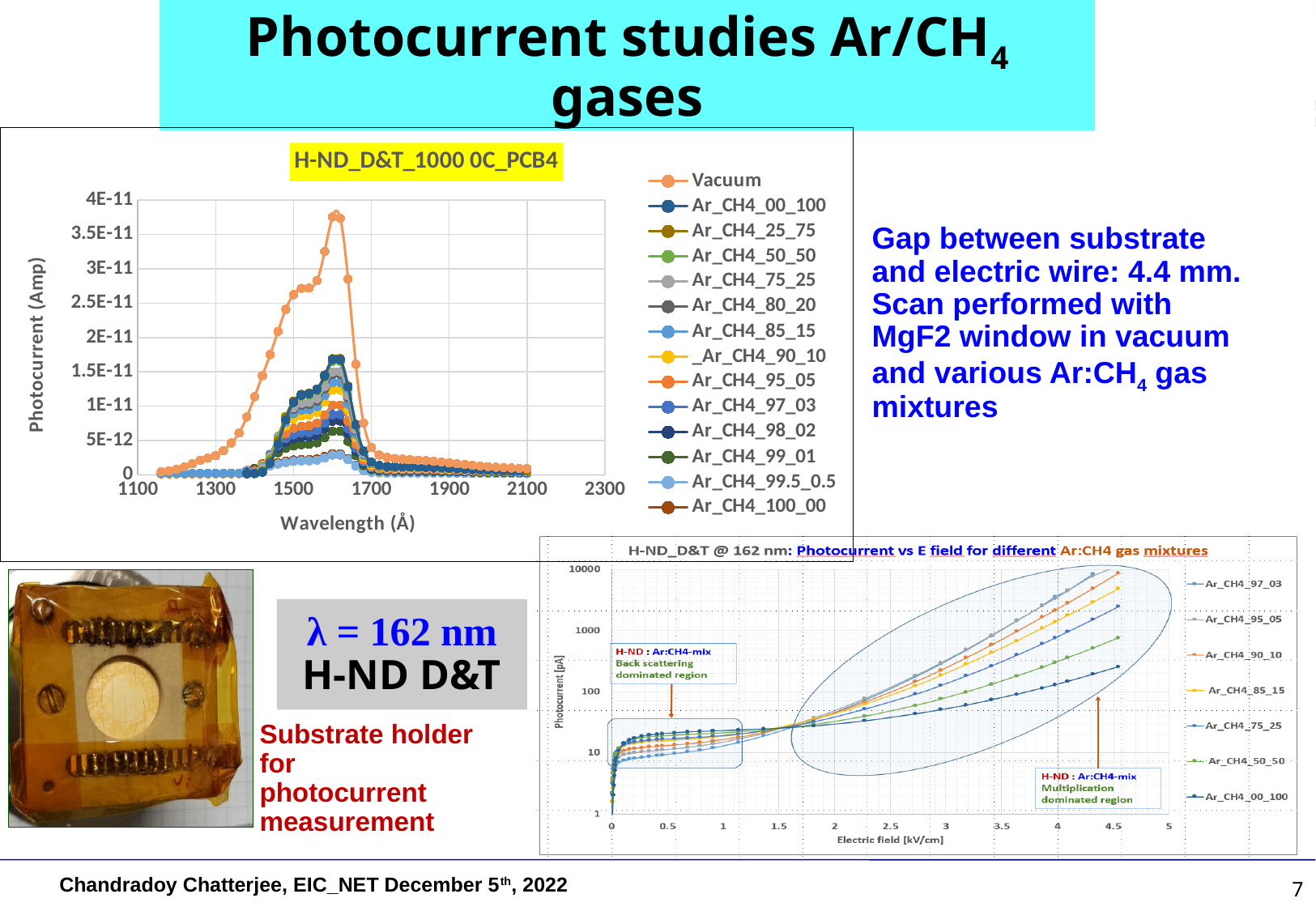
In the top-left chart titled H-ND_D&T_1000 0C_PCB4, what is the label of the x axis? Wavelength (Å) In the bottom-right chart (Photocurrent vs E field), is the photocurrent of Ar_CH4_00_100 at 4.5 kV/cm greater or less than 1000 pA? less In the top-left chart titled H-ND_D&T_1000 0C_PCB4, what kind of chart is shown? line chart In the bottom-right chart (Photocurrent vs E field), how many series does the legend list? 7 In the top-left chart titled H-ND_D&T_1000 0C_PCB4, which series reaches the highest photocurrent? Vacuum In the top-left chart titled H-ND_D&T_1000 0C_PCB4, is the peak value of the Ar_CH4_100_00 series greater or less than 5E-12? less In the top-left chart titled H-ND_D&T_1000 0C_PCB4, is the peak value of the Vacuum series greater or less than 3.5E-11? greater In the bottom-right chart (Photocurrent vs E field), which series has the lowest photocurrent at 4.5 kV/cm? Ar_CH4_00_100 In the top-left chart titled H-ND_D&T_1000 0C_PCB4, how many series does the legend list? 14 In the bottom-right chart (Photocurrent vs E field), does the photocurrent rise or fall as the electric field increases above 2 kV/cm? rise In the bottom-right chart (Photocurrent vs E field), what is the label of the x axis? Electric field [kV/cm]